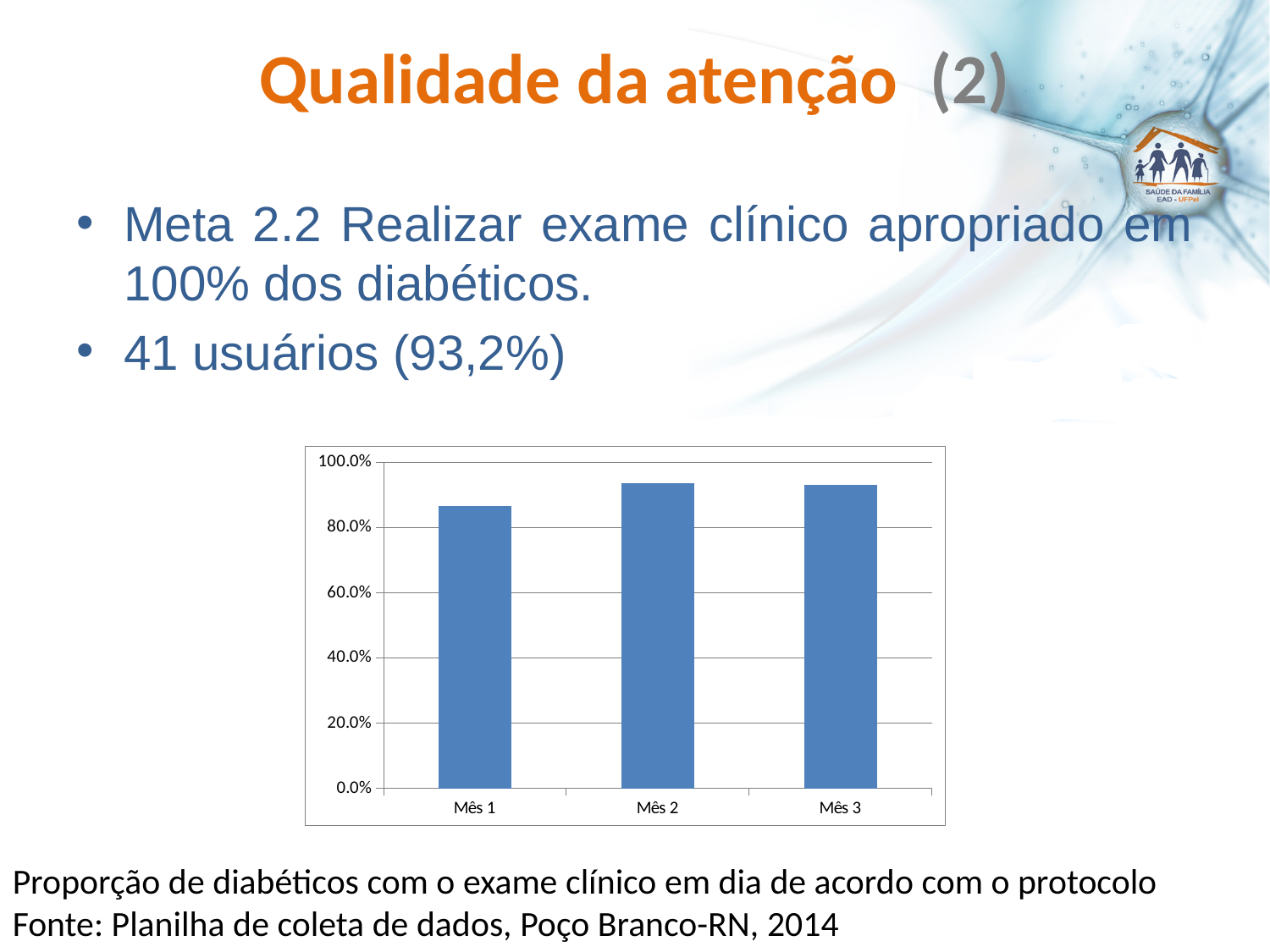
Is the value for Mês 2 greater or less than 80.0%? greater Which month has the lowest bar in the chart? Mês 1 Is the value for Mês 1 greater or less than 100.0%? less Which is larger, the value for Mês 1 or the value for Mês 3? Mês 3 How many categories (months) are plotted on the x axis of the chart? 3 What kind of chart is shown on the slide? bar chart Which is larger, the value for Mês 1 or the value for Mês 2? Mês 2 Is the value for Mês 3 greater or less than 100.0%? less What is the highest value shown on the chart's y axis? 100.0% What colour are the bars in the chart? blue